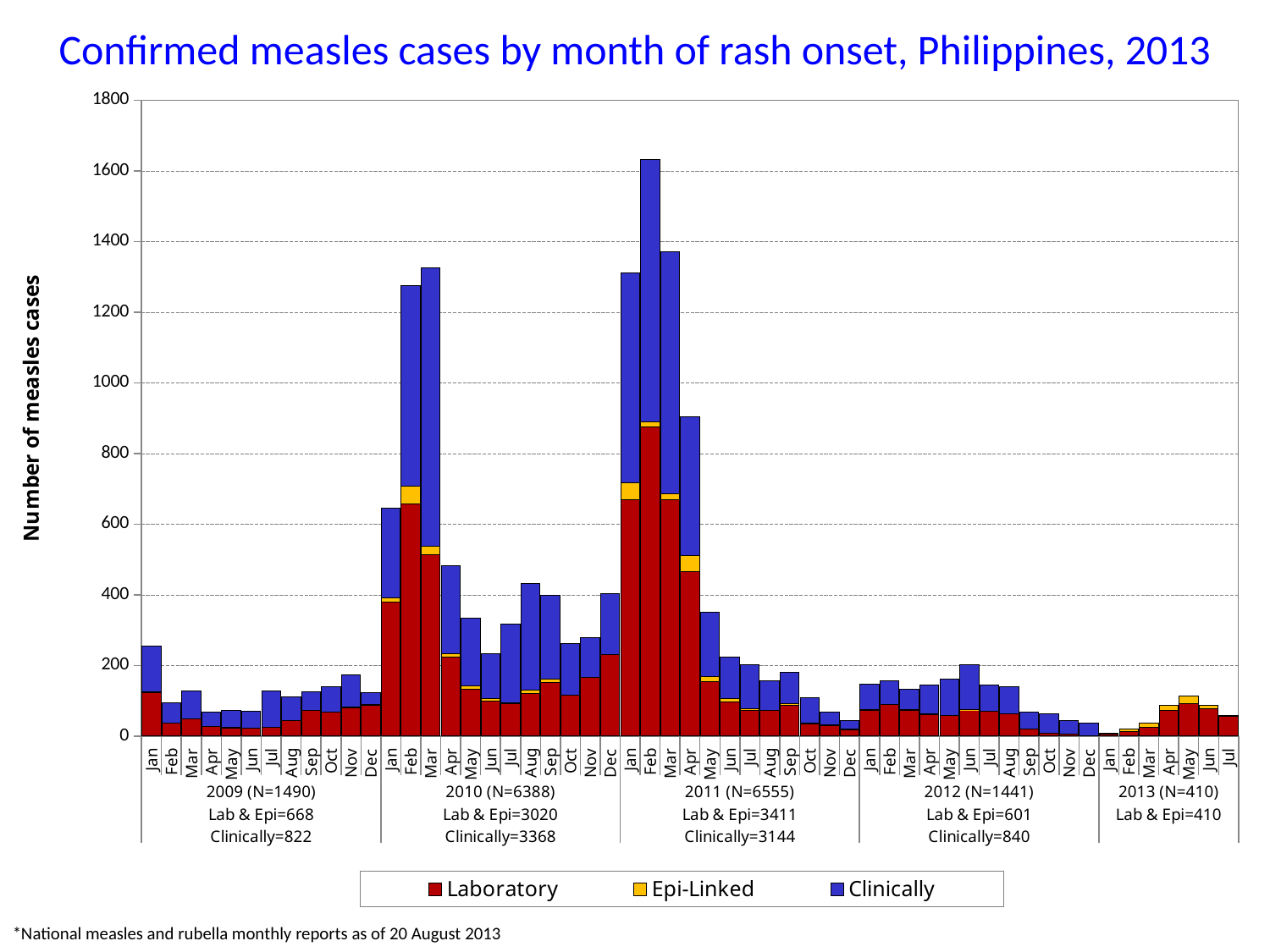
What are the three series named in the legend? Laboratory, Epi-Linked, Clinically What kind of chart is shown on the slide? Stacked bar chart How many series does the legend list? 3 What is the Clinically count shown for 2009? 822 What is the difference between the total N for 2011 and the total N for 2010? 167 How many years are shown along the x axis? 5 What is the total number of cases (N) shown for 2012? 1441 Is the total bar for Feb 2011 greater or less than 1400? greater Which is larger, the Lab & Epi count for 2010 or for 2011? 2011 (3411) Which year has the highest total N? 2011 (N=6555) Is the total bar for Jan 2009 greater or less than 200? greater Which year has the lowest total N? 2013 (N=410)